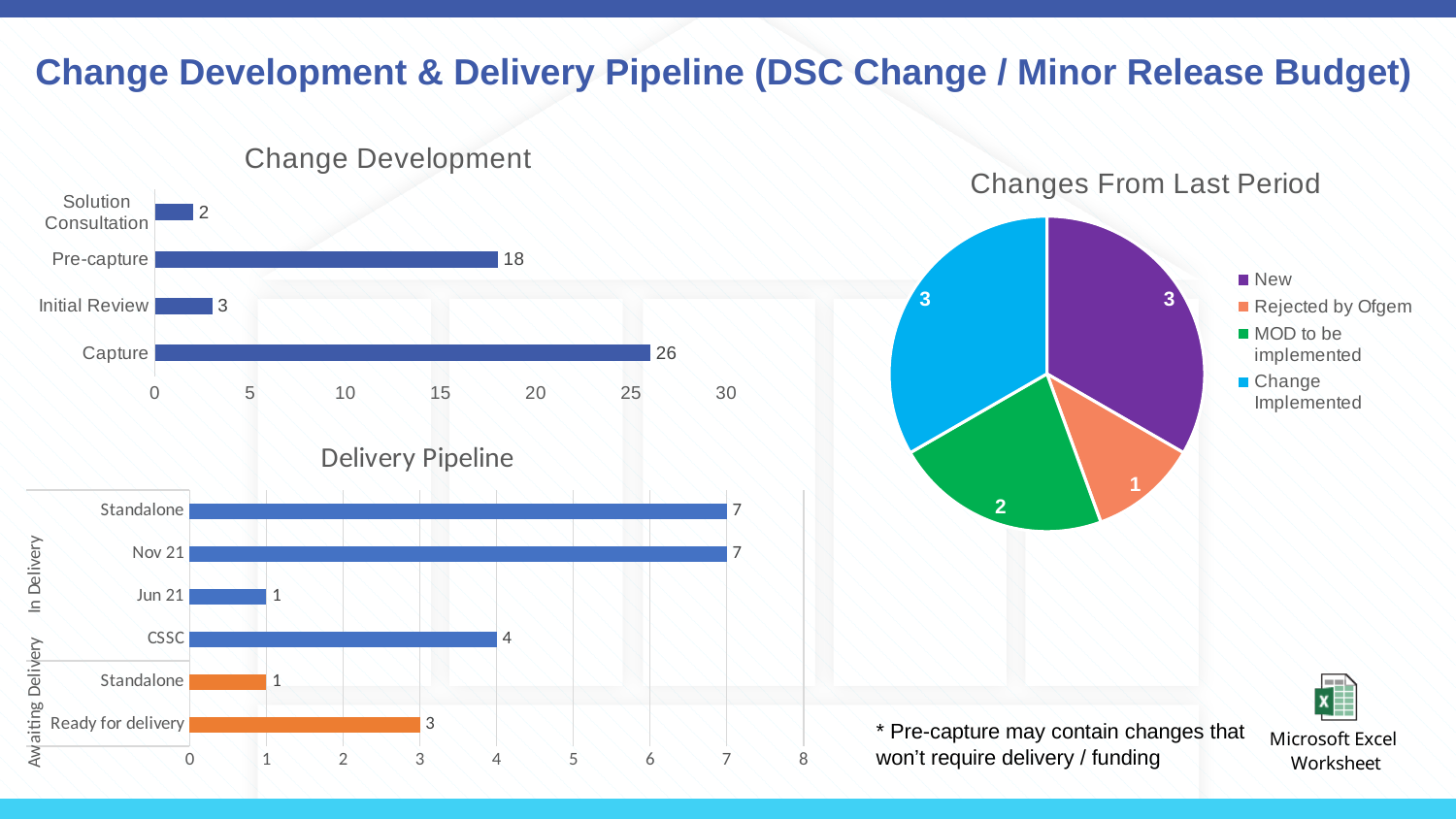
How many entries does the legend of the Changes From Last Period chart list? 4 In the Change Development chart, which category has the lowest value? Solution Consultation In the Delivery Pipeline chart, what is the value for CSSC? 4 In the Change Development chart, what is the value for Pre-capture? 18 In the Changes From Last Period chart, what is the value for Rejected by Ofgem? 1 In the Delivery Pipeline chart, what is the difference between Nov 21 and CSSC? 3 In the Change Development chart, what is the difference between Capture and Pre-capture? 8 What kind of chart is the Changes From Last Period chart? Pie chart In the Change Development chart, what is the value for Capture? 26 In the Delivery Pipeline chart, which is larger, Nov 21 or Jun 21? Nov 21 In the Change Development chart, how many categories are shown? 4 In the Delivery Pipeline chart, what is the value for Ready for delivery under Awaiting Delivery? 3